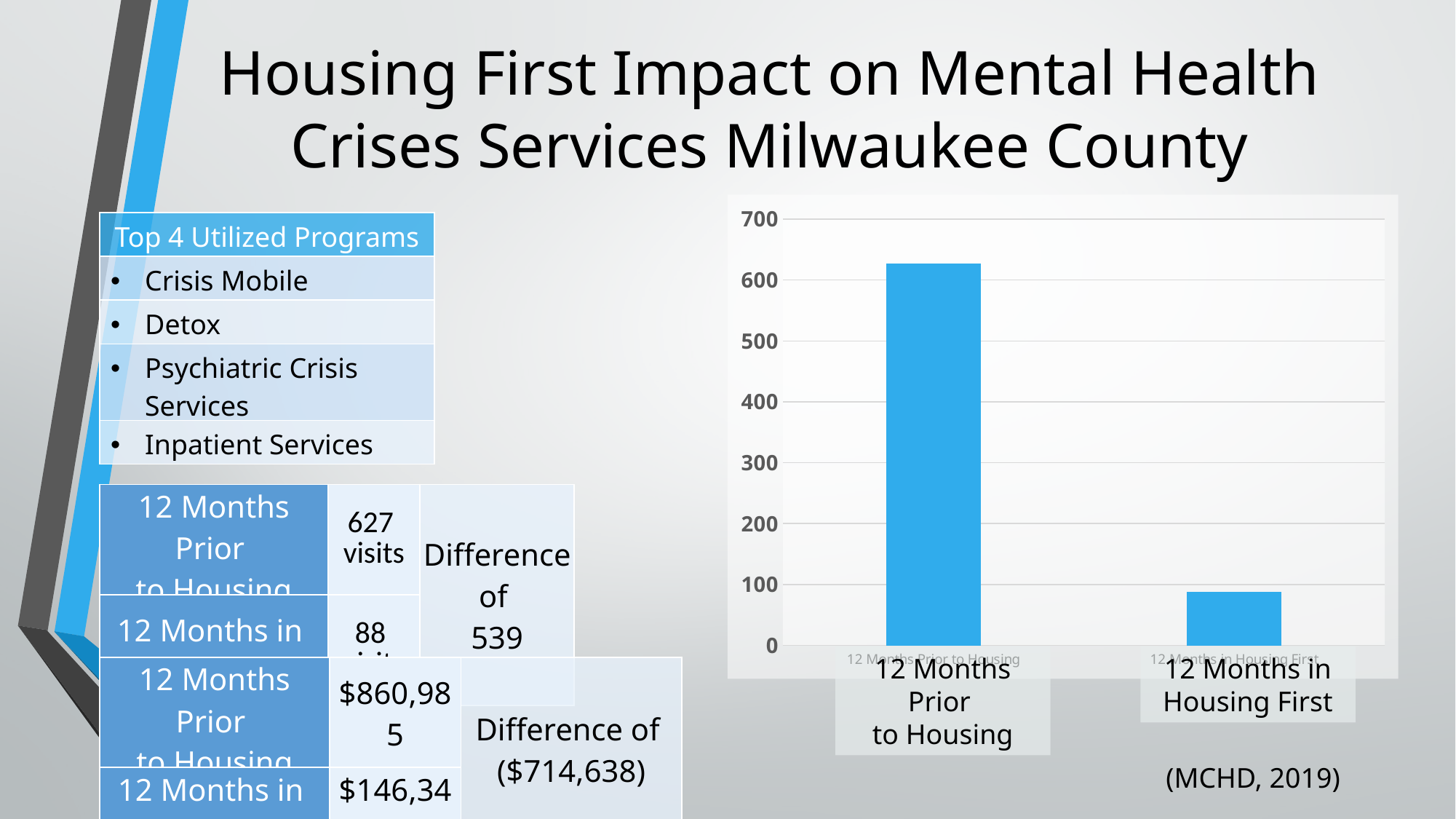
What kind of chart is shown on the slide? bar chart What is the highest tick value shown on the chart's vertical axis? 700 Is the value for 12 Months Prior to Housing greater or less than 700? less Which category has the highest value in the chart? 12 Months Prior to Housing Which category has the lowest value in the chart? 12 Months in Housing First Which is larger in the chart: the value for 12 Months Prior to Housing or the value for 12 Months in Housing First? 12 Months Prior to Housing How many bars does the chart show? 2 What colour are the bars in the chart? blue Do the values rise or fall from 12 Months Prior to Housing to 12 Months in Housing First? fall Is the value for 12 Months in Housing First greater or less than 200? less Is the value for 12 Months in Housing First greater or less than 100? less